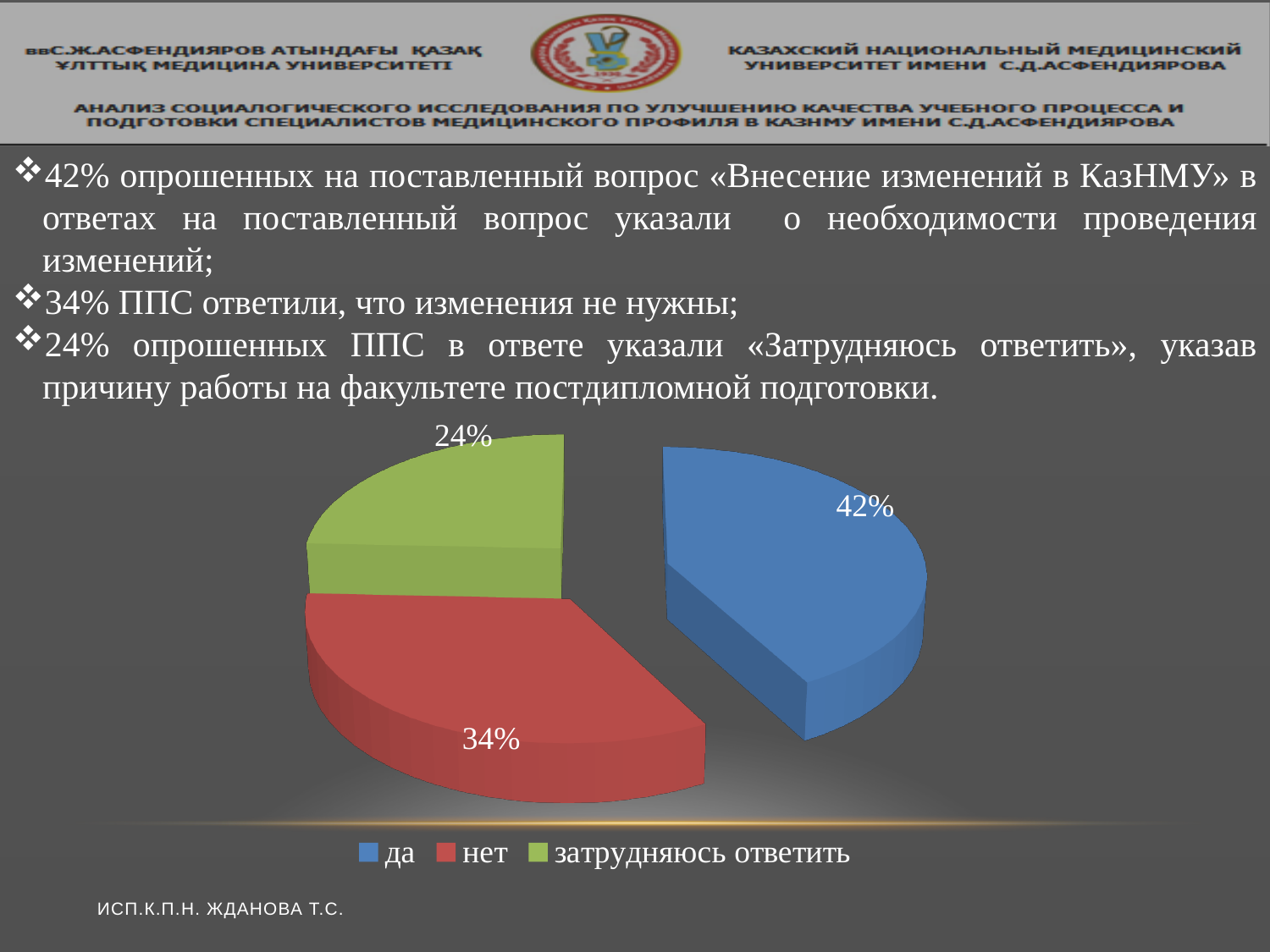
Which category has the smallest slice of the pie? затрудняюсь ответить What colour is the "да" slice? blue What is the difference between the "да" and "нет" shares? 8% What share of the pie does the "затрудняюсь ответить" slice represent? 24% What is the difference between the "нет" and "затрудняюсь ответить" shares? 10% Which is larger, the "нет" slice or the "затрудняюсь ответить" slice? нет What share of the pie does the "да" slice represent? 42% What kind of chart is shown on the slide? pie chart Which category has the largest slice of the pie? да What share of the pie does the "нет" slice represent? 34% Which category is shown in green in the legend? затрудняюсь ответить How many slices does the pie chart have? 3